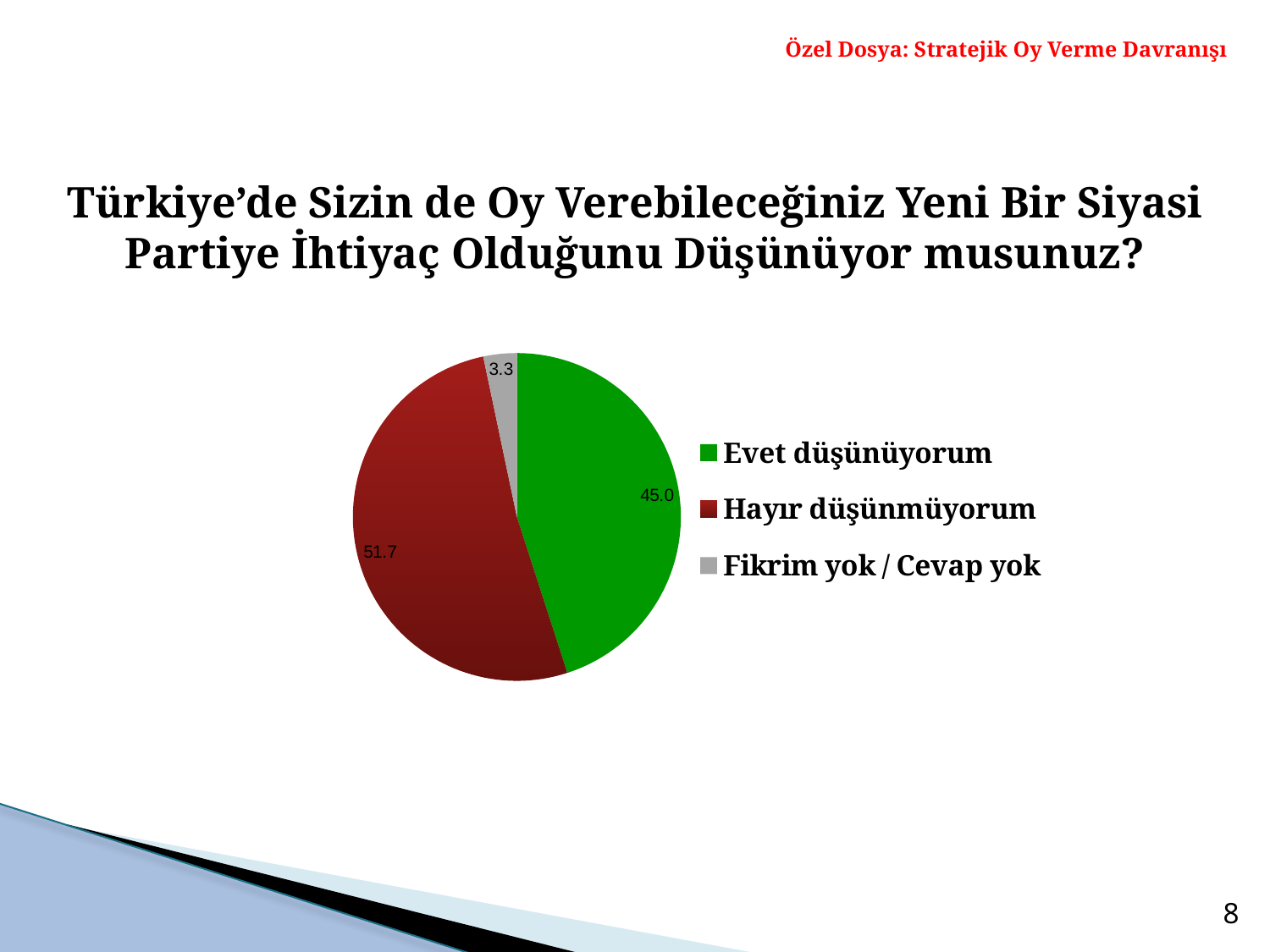
What colour is the slice for "Fikrim yok / Cevap yok"? grey Which category has the largest slice of the pie? Hayır düşünmüyorum How many entries does the legend list? 3 Which is larger, the value for "Evet düşünüyorum" or the value for "Hayır düşünmüyorum"? Hayır düşünmüyorum What is the difference between the values for "Hayır düşünmüyorum" and "Evet düşünüyorum"? 6.7 How many categories does the pie chart have? 3 What is the value for "Fikrim yok / Cevap yok"? 3.3 What kind of chart is shown on the slide? pie chart What is the value for "Evet düşünüyorum"? 45.0 Which category has the smallest slice of the pie? Fikrim yok / Cevap yok What is the value for "Hayır düşünmüyorum"? 51.7 What colour is the slice for "Evet düşünüyorum"? green